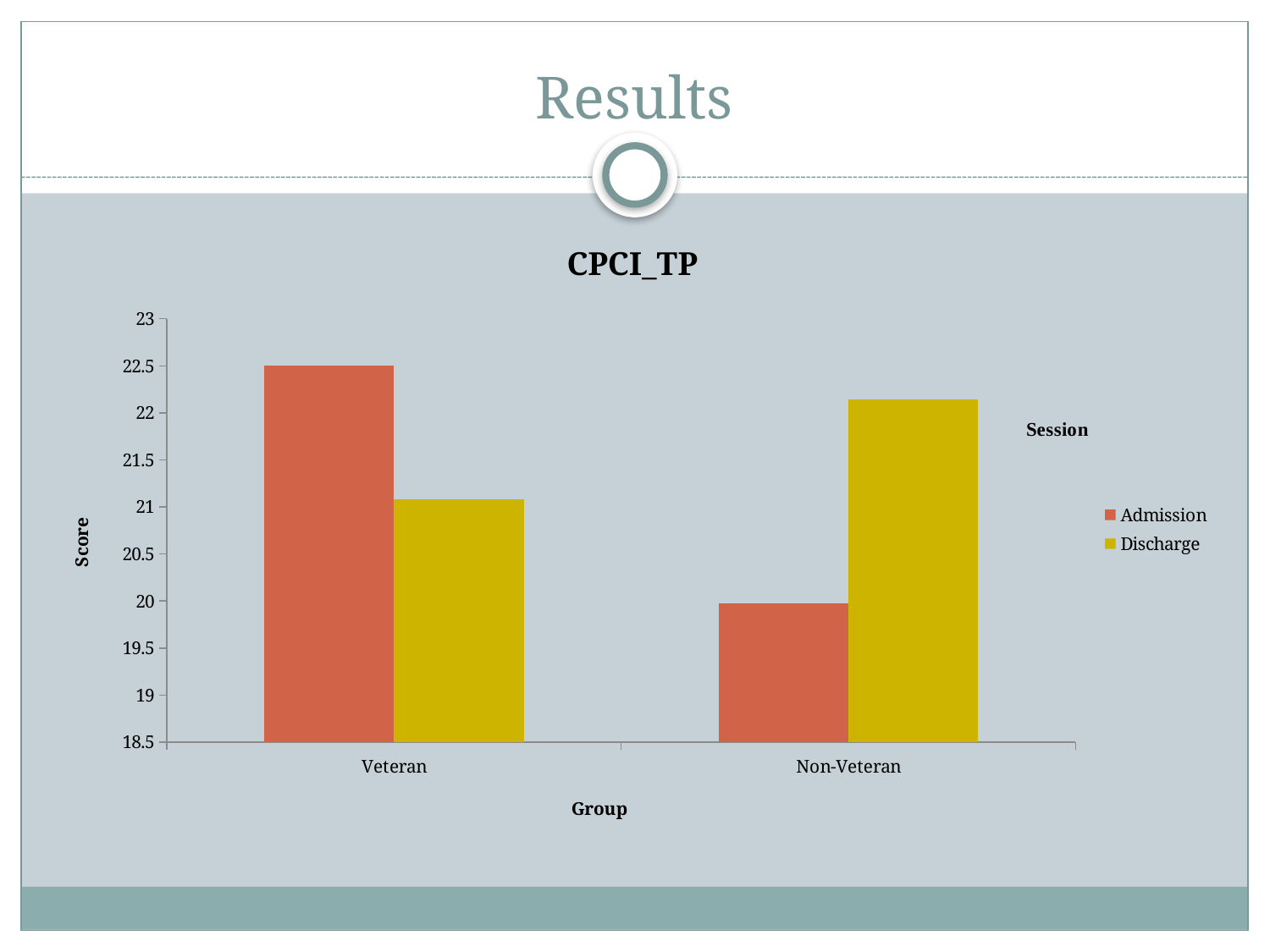
Is the Admission value for Veteran greater or less than 22? greater For the Veteran group, which is larger, the Admission score or the Discharge score? Admission Is the Discharge value for Veteran greater or less than 21.5? less How many series does the legend list? 2 What is the title of the chart? CPCI_TP Which bar is the highest in the chart? Veteran, Admission What kind of chart is shown on the slide? bar chart Which bar is the lowest in the chart? Non-Veteran, Admission For the Non-Veteran group, which is larger, the Admission score or the Discharge score? Discharge What is the label of the y axis? Score How many groups are shown on the x axis? 2 Is the Admission value for Non-Veteran greater or less than 20.5? less